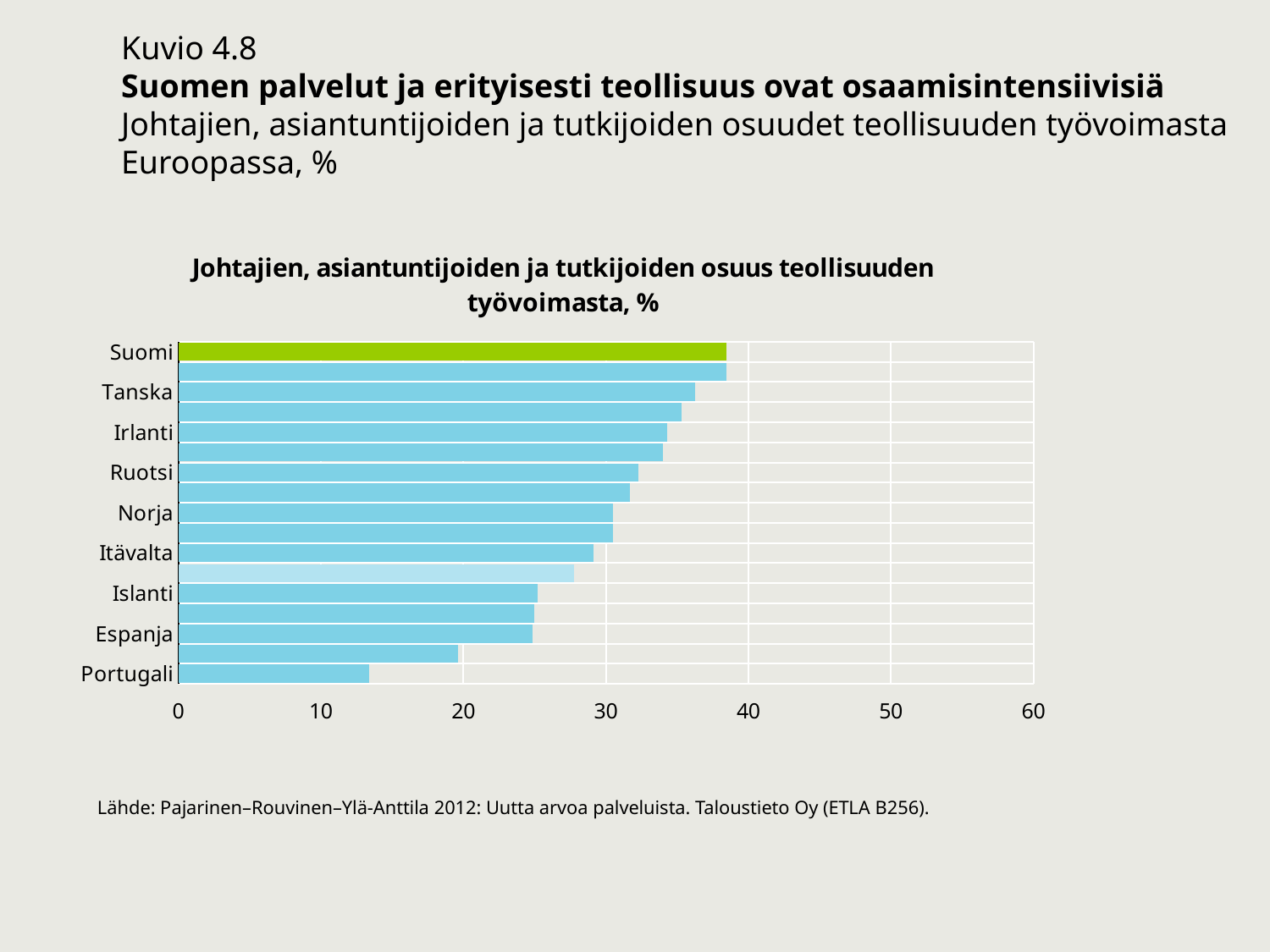
Is the value for Suomi greater or less than 30? greater Which has a larger value, Tanska or Espanja? Tanska Is the value for Espanja greater or less than 20? greater What kind of chart is shown on the slide? bar chart Is the value for Irlanti greater or less than 30? greater Which country's bar is coloured green rather than blue? Suomi What is the highest value shown on the x axis? 60 Which labelled country has the highest share of managers, experts and researchers in the industrial workforce? Suomi Which labelled country has the lowest share of managers, experts and researchers in the industrial workforce? Portugali Which has a larger value, Suomi or Portugali? Suomi